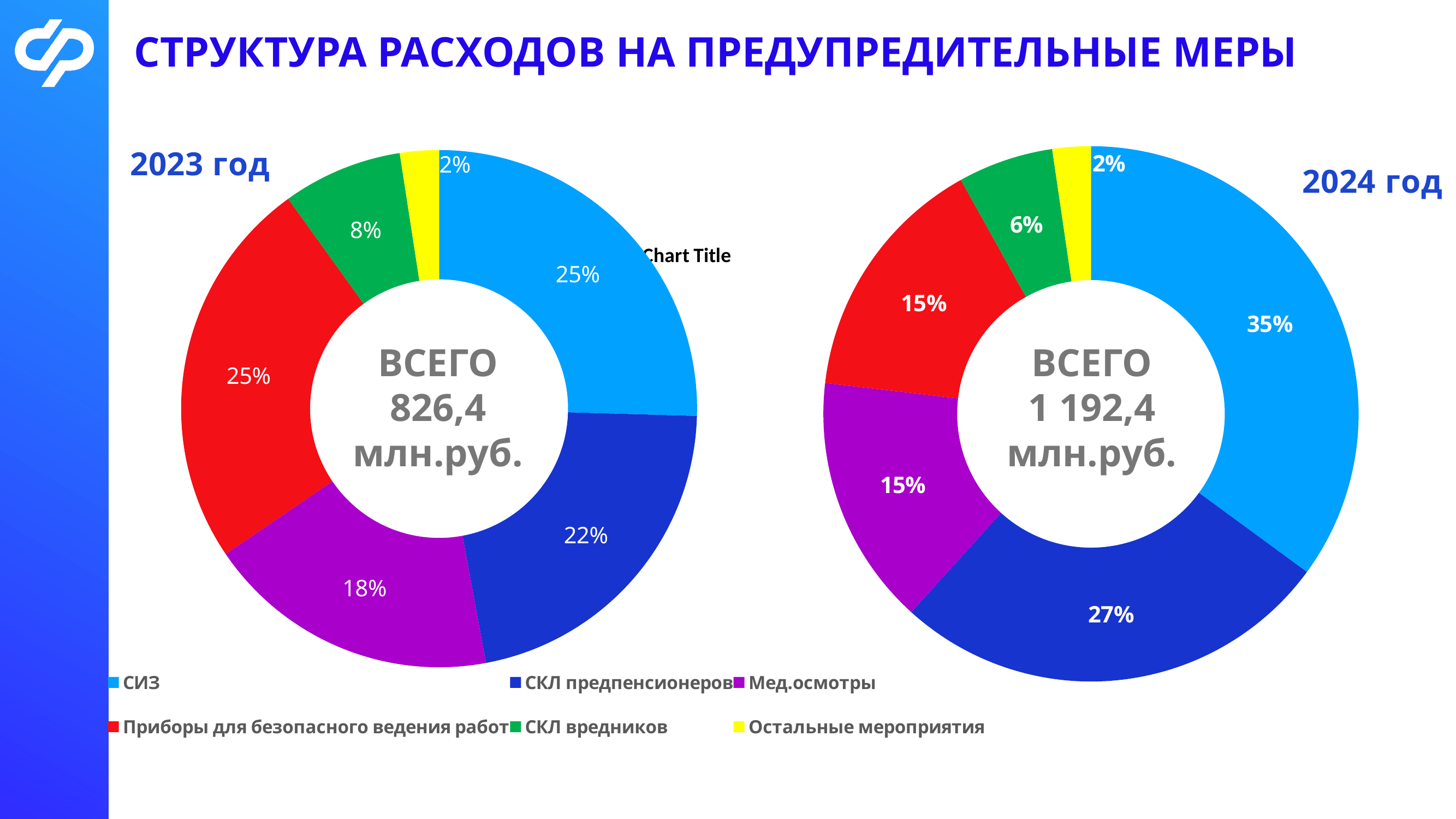
What total is shown in the centre of the 2023 год chart? 826,4 млн.руб. In the 2024 год chart, which category has the largest share? СИЗ In the 2024 год chart, what share does СИЗ have? 35% In the 2023 год chart, what share does СИЗ have? 25% In the 2023 год chart, which is larger: the share of СКЛ предпенсионеров or the share of Мед.осмотры? СКЛ предпенсионеров What total is shown in the centre of the 2024 год chart? 1 192,4 млн.руб. In the 2024 год chart, what is the difference between the shares of СИЗ and СКЛ вредников? 29% What kind of chart is the 2023 год chart? Pie (donut) chart In the 2023 год chart, which category has the smallest share? Остальные мероприятия How many categories does the 2024 год chart show? 6 In the 2023 год chart, what share does Мед.осмотры have? 18% In the 2024 год chart, what share does СКЛ предпенсионеров have? 27%